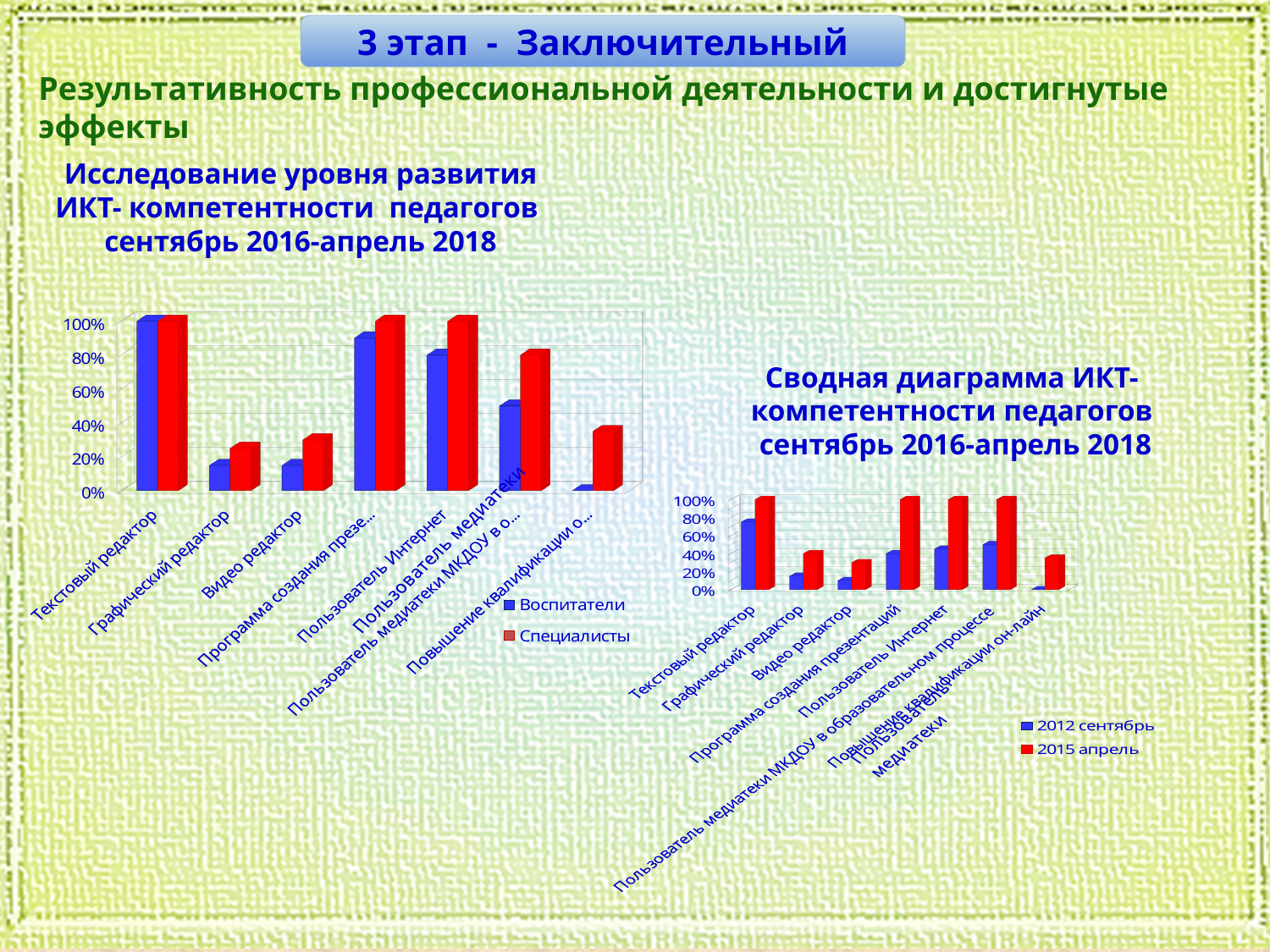
How many series does the legend of the right chart («Сводная диаграмма ИКТ-компетентности педагогов») list? 2 In the left chart («Исследование уровня развития ИКТ-компетентности педагогов»), is the Воспитатели value for Пользователь Интернет greater or less than 60%? greater In the left chart («Исследование уровня развития ИКТ-компетентности педагогов»), is the Специалисты value for Пользователь Интернет greater or less than 80%? greater What are the legend entries of the right chart («Сводная диаграмма ИКТ-компетентности педагогов»)? 2012 сентябрь, 2015 апрель In the right chart («Сводная диаграмма ИКТ-компетентности педагогов»), is the 2015 апрель value for Пользователь Интернет greater or less than 80%? greater How many series does the legend of the left chart («Исследование уровня развития ИКТ-компетентности педагогов») list? 2 What kind of chart is the left chart titled «Исследование уровня развития ИКТ-компетентности педагогов»? bar chart What kind of chart is the right chart titled «Сводная диаграмма ИКТ-компетентности педагогов»? bar chart In the left chart («Исследование уровня развития ИКТ-компетентности педагогов»), which is larger for Видео редактор: Воспитатели or Специалисты? Специалисты In the right chart («Сводная диаграмма ИКТ-компетентности педагогов»), which is larger for Графический редактор: 2012 сентябрь or 2015 апрель? 2015 апрель What are the legend entries of the left chart («Исследование уровня развития ИКТ-компетентности педагогов»)? Воспитатели, Специалисты